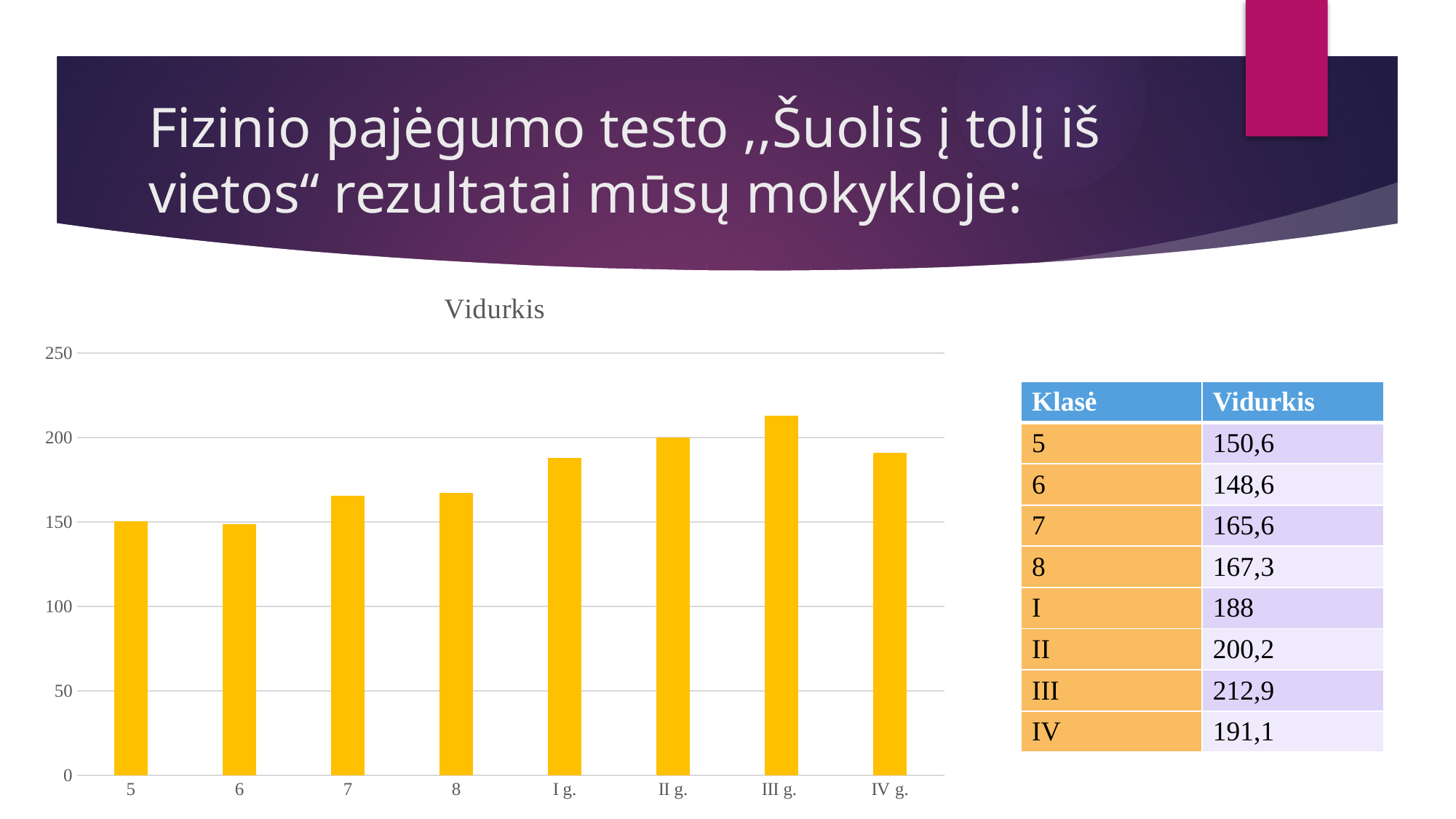
What kind of chart is shown on the slide? bar chart What is the difference between the values for III g. and II g.? 12,7 Do the values generally rise or fall from category 5 to III g.? rise Which is larger, the value for II g. or the value for 8? II g. Is the value for IV g. greater or less than 200? less Is the value for 7 greater or less than 150? greater How many categories are plotted on the x axis of the chart? 8 What is the value for III g. according to the slide? 212,9 What is the title of the chart? Vidurkis Which category has the highest bar in the chart? III g. Which category has the lowest value in the chart? 6 What is the value for I g. according to the slide? 188